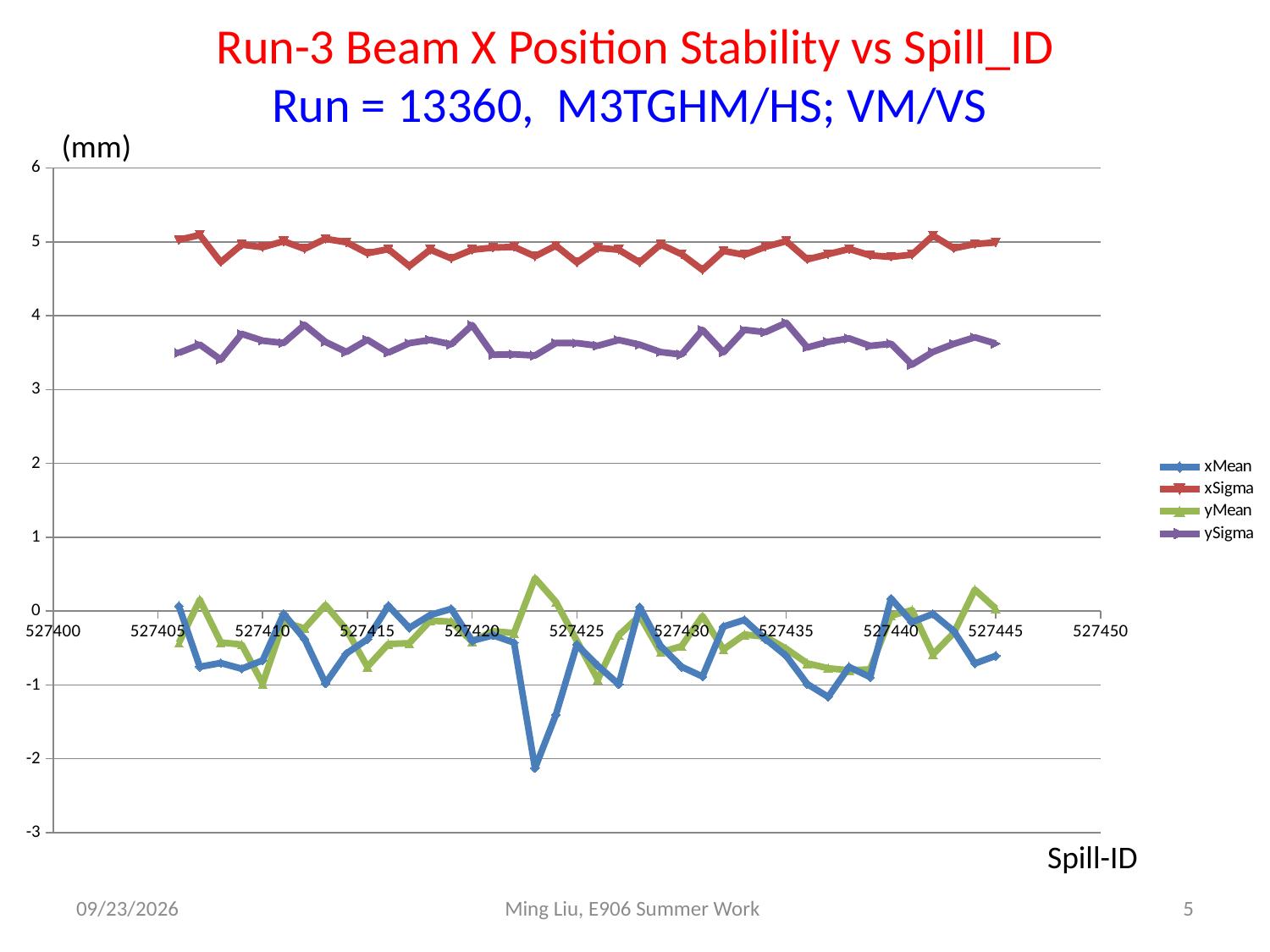
Are the ySigma values greater or less than 3? greater What unit is shown for the vertical axis? (mm) Which series reaches the lowest value on the chart? xMean Are the ySigma values greater or less than 4? less Which series has the highest values across the chart? xSigma Are the xSigma values greater or less than 4? greater How many series does the legend list? 4 What are the series names listed in the legend? xMean, xSigma, yMean, ySigma Which series has larger values, xSigma or ySigma? xSigma What kind of chart is shown on the slide? line chart